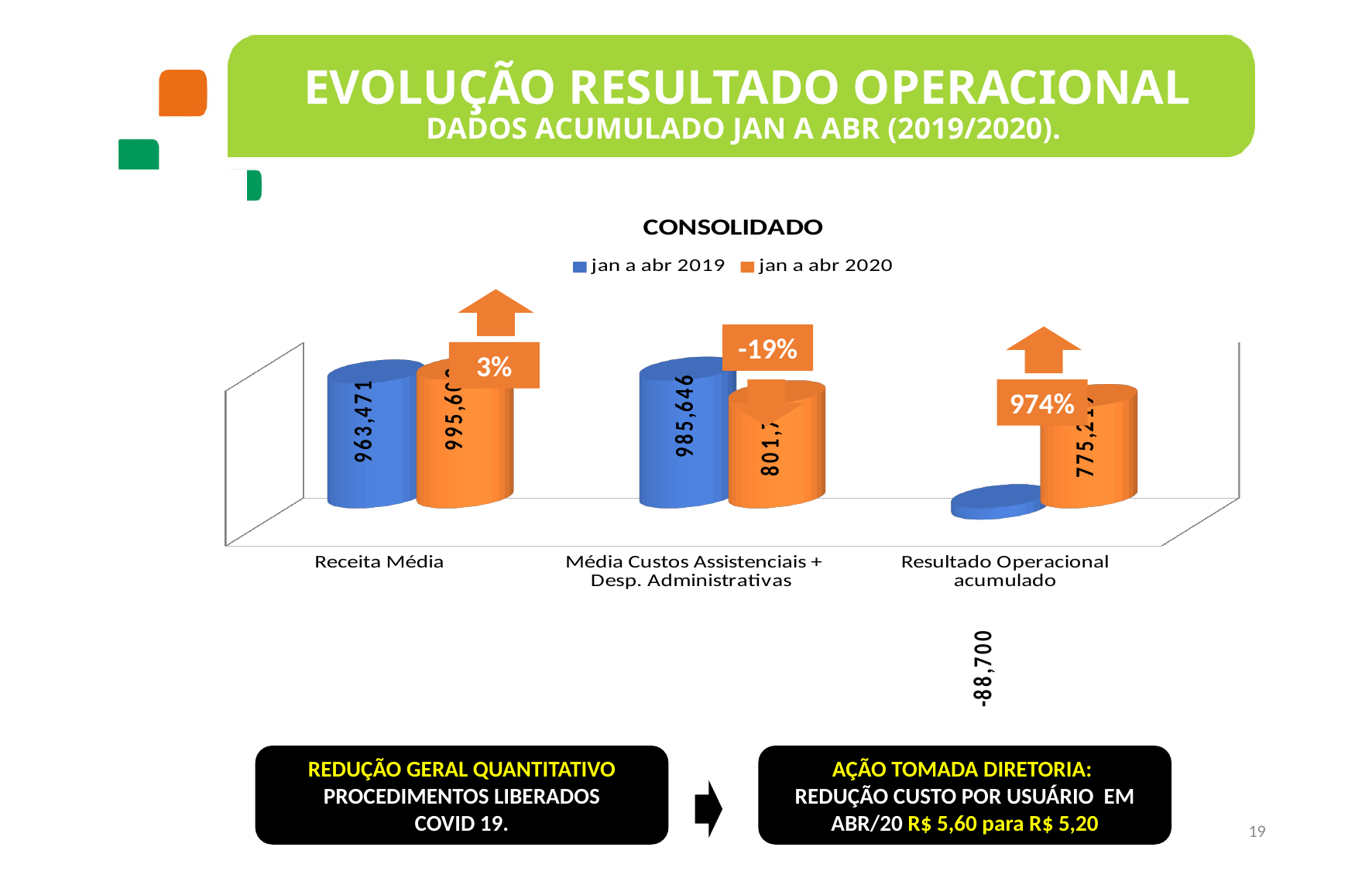
What is the value for Média Custos Assistenciais + Desp. Administrativas in the jan a abr 2019 series? 985,646 For Resultado Operacional acumulado, which series has the larger value, jan a abr 2019 or jan a abr 2020? jan a abr 2020 How many series does the legend of the CONSOLIDADO chart list? 2 What is the value for Receita Média in the jan a abr 2019 series? 963,471 What is the value for Resultado Operacional acumulado in the jan a abr 2019 series? -88,700 What percentage change label is shown above the Receita Média bars? 3% For Média Custos Assistenciais + Desp. Administrativas, which series has the larger value, jan a abr 2019 or jan a abr 2020? jan a abr 2019 Which category has the lowest value in the jan a abr 2019 series? Resultado Operacional acumulado What is the difference between the jan a abr 2019 values for Média Custos Assistenciais + Desp. Administrativas and Receita Média? 22,175 How many categories are shown on the x axis of the CONSOLIDADO chart? 3 What kind of chart is shown on the slide? bar chart Which category has the highest value in the jan a abr 2019 series? Média Custos Assistenciais + Desp. Administrativas